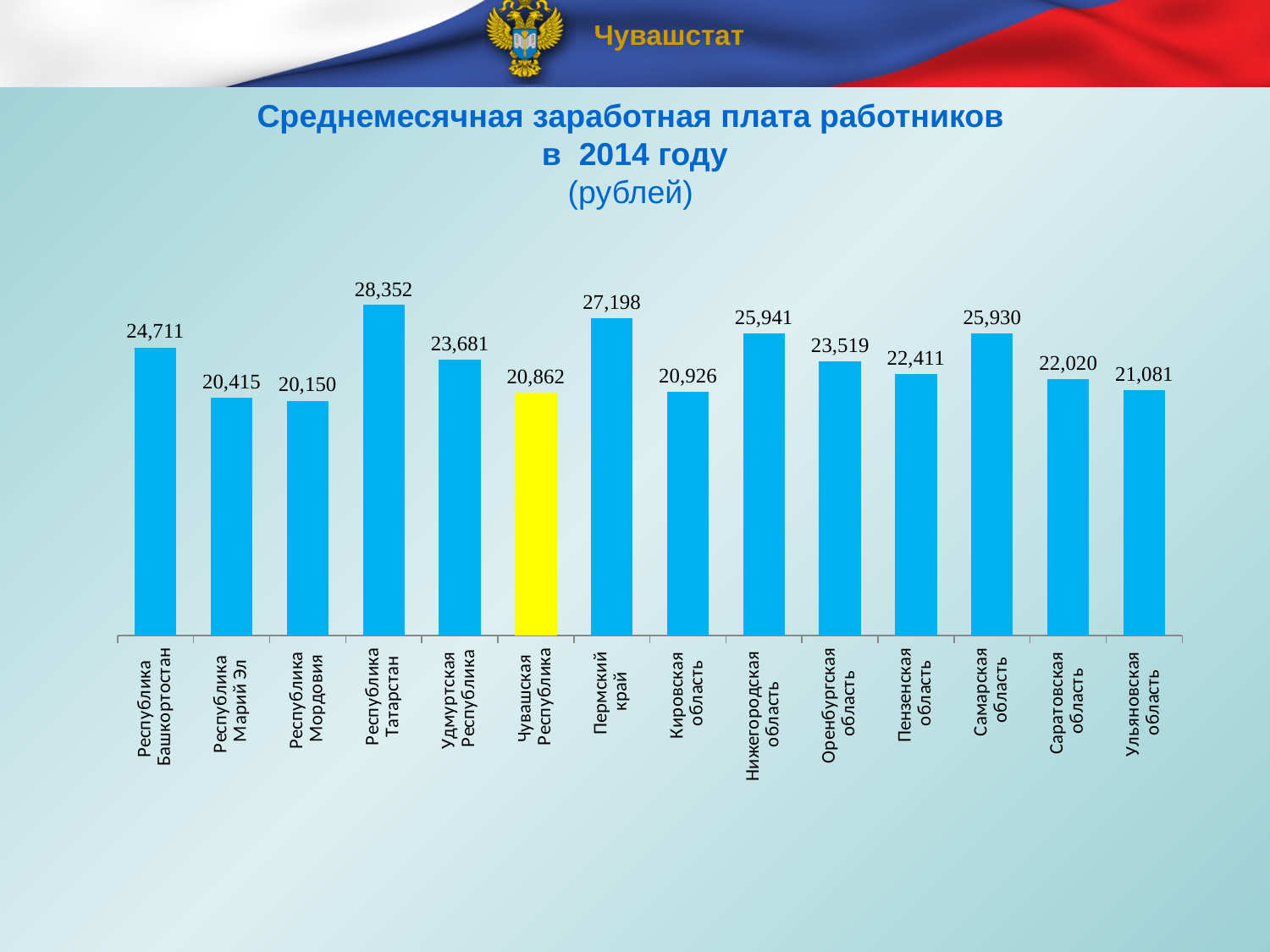
What is the average monthly wage shown for Республика Татарстан? 28,352 What value is shown for Чувашская Республика? 20,862 Which region has the highest average monthly wage on the chart? Республика Татарстан Which is larger, the value for Пермский край or the value for Республика Башкортостан? Пермский край What is the difference between the values for Республика Башкортостан and Республика Марий Эл? 4,296 Which region's bar is highlighted in yellow? Чувашская Республика How many regions are shown on the chart? 14 Which region has the lowest average monthly wage on the chart? Республика Мордовия What value is labelled for Пензенская область? 22,411 What is the difference between the values for Республика Татарстан and Чувашская Республика? 7,490 What kind of chart is shown on the slide? Bar chart What is the value for Кировская область? 20,926